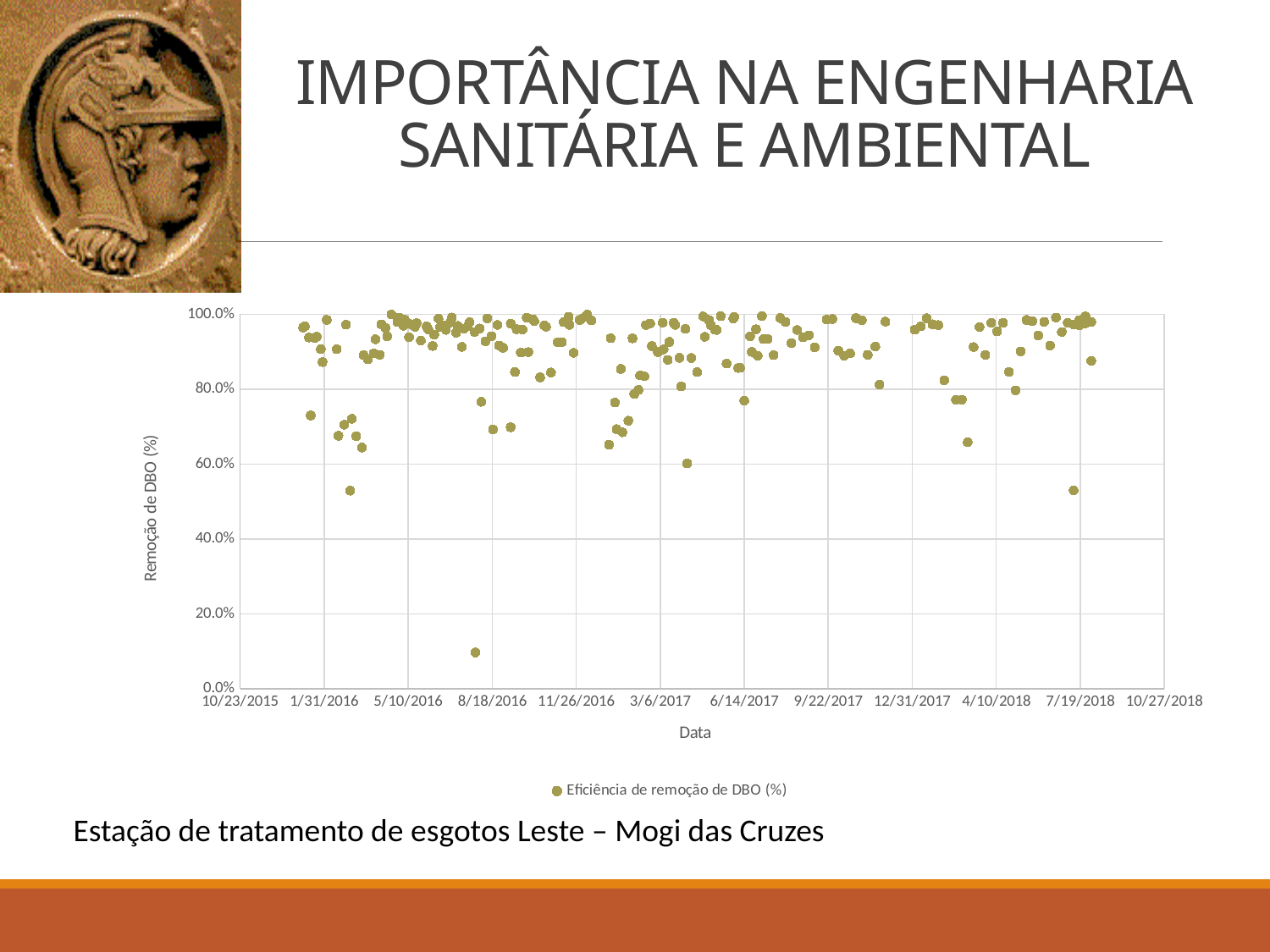
What kind of chart is shown on the slide? Scatter chart Are the majority of the plotted points in the chart greater or less than 80.0%? greater Is the lowest plotted value near 7/19/2018 greater or less than 60.0%? less What is the legend entry of the series plotted in the chart? Eficiência de remoção de DBO (%) Is the lowest plotted value near 3/6/2017 greater or less than 40.0%? greater What is the title of the vertical axis of the chart? Remoção de DBO (%) How many series does the legend of the chart list? 1